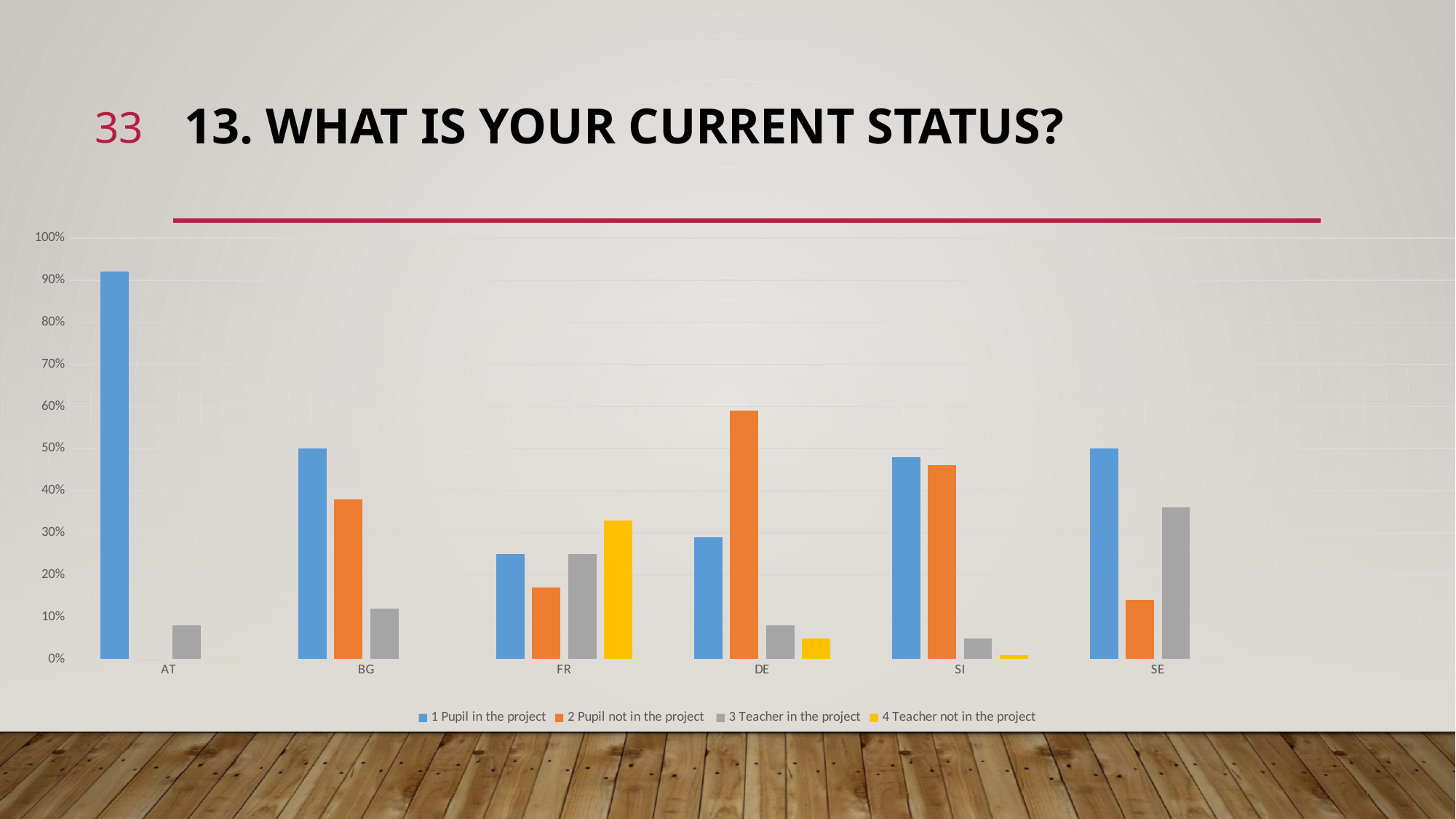
How many countries are shown on the x axis of the chart? 6 Is the value for '3 Teacher in the project' in SE greater or less than 30%? greater Is the value for '3 Teacher in the project' in BG greater or less than 20%? less Which country has the highest value for '3 Teacher in the project'? SE Which country has the highest value for '1 Pupil in the project'? AT How many series does the chart legend list? 4 What is the title of the chart slide? 13. WHAT IS YOUR CURRENT STATUS? Is the value for '2 Pupil not in the project' in DE greater or less than 50%? greater In BG, which is larger: '1 Pupil in the project' or '2 Pupil not in the project'? 1 Pupil in the project What kind of chart is shown on the slide? bar chart Which country has the highest value for '2 Pupil not in the project'? DE